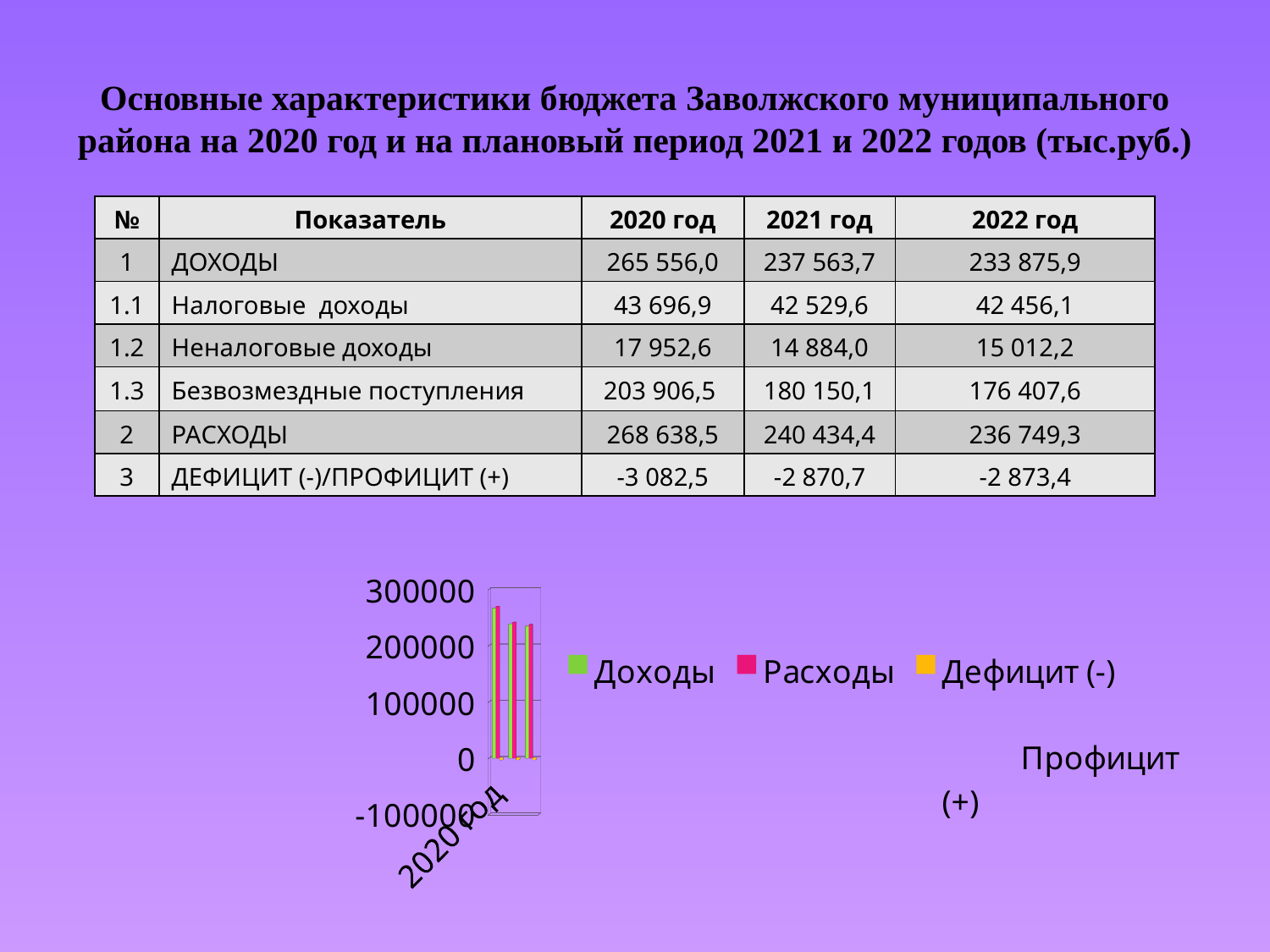
Is the value for Доходы in 2020 год greater or less than 100000? greater Which series is shown in pink in the chart legend? Расходы Which series is shown in green in the chart legend? Доходы How many series does the chart legend list? 3 How many groups of bars are plotted in the chart? 3 Do the Расходы bars rise or fall from left to right along the x axis? fall Do the Доходы bars rise or fall from left to right along the x axis? fall What kind of chart is shown at the bottom of the slide? bar chart Is the value for Дефицит (-) Профицит (+) in 2020 год greater or less than 100000? less Is the value for Расходы in 2020 год greater or less than 300000? less